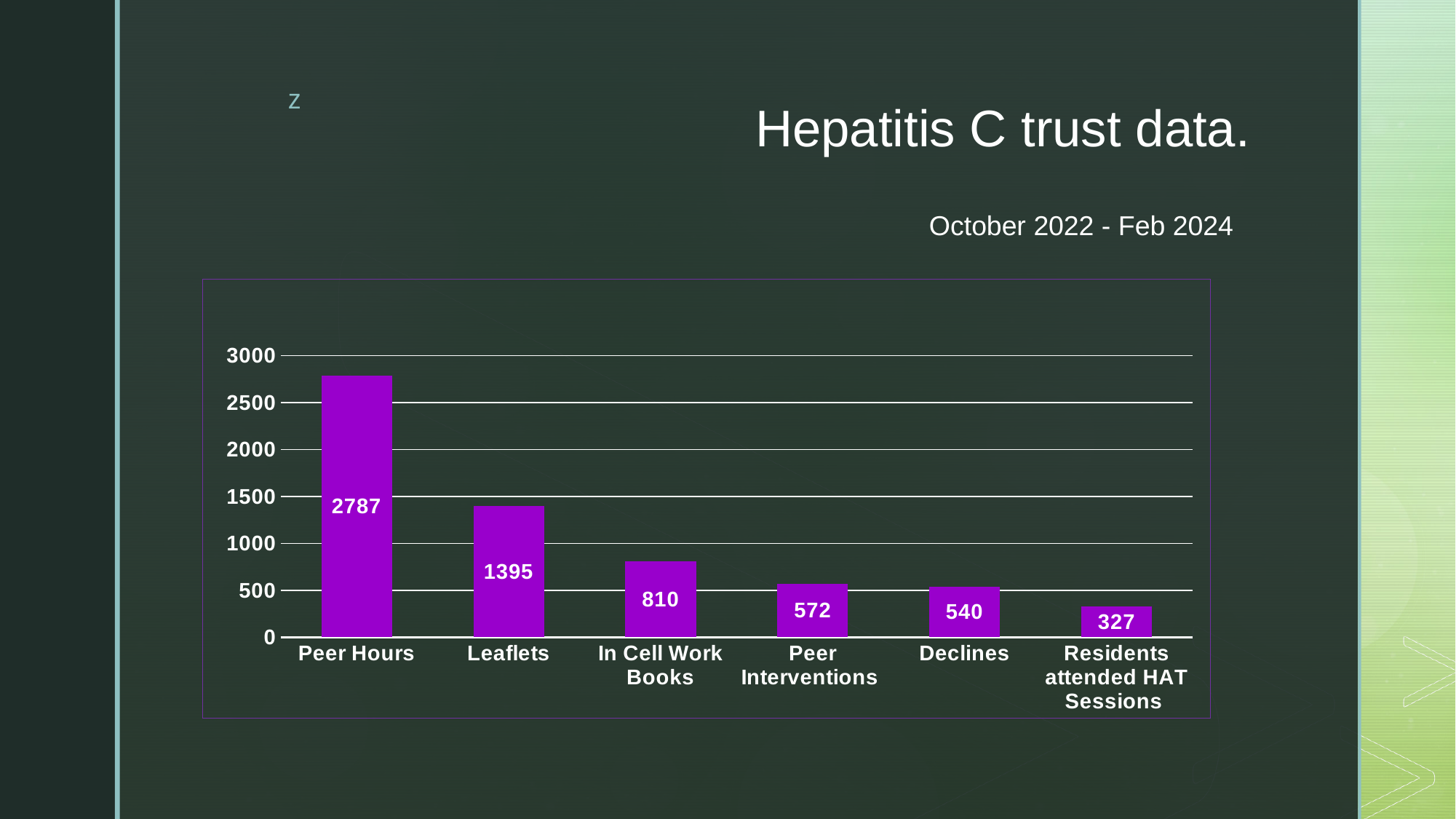
What is the value for In Cell Work Books? 810 What is the value for Leaflets? 1395 What is the difference between the values for Peer Interventions and Declines? 32 What kind of chart is shown on the slide? Bar chart What is the value for Residents attended HAT Sessions? 327 Which is larger, the value for In Cell Work Books or the value for Declines? In Cell Work Books How many categories are shown on the chart? 6 Which category has the lowest value? Residents attended HAT Sessions What is the difference between the values for Peer Hours and Leaflets? 1392 Which category has the highest value? Peer Hours What time period does the slide say the data covers? October 2022 - Feb 2024 What is the value for Peer Hours? 2787